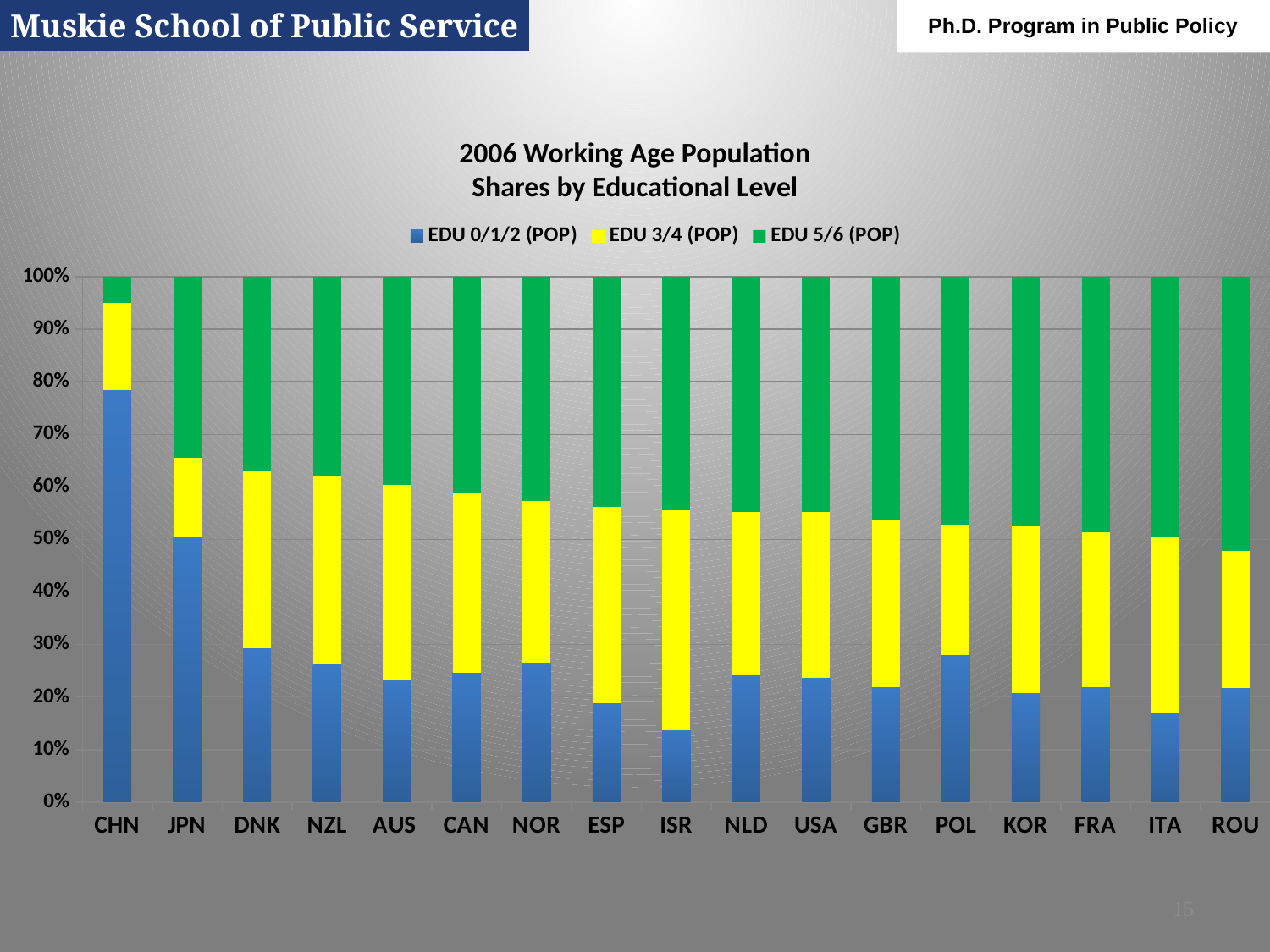
Which country has the largest share for EDU 5/6 (POP)? ROU Which country has the smallest share for EDU 5/6 (POP)? CHN Is the EDU 0/1/2 (POP) share for CHN greater or less than 70%? greater How many series does the legend list? 3 How many countries are shown on the x axis? 17 Is the EDU 0/1/2 (POP) share for ISR greater or less than 20%? less What is the title of the chart? 2006 Working Age Population Shares by Educational Level Which country has the highest share for EDU 0/1/2 (POP)? CHN Which country has the lowest share for EDU 0/1/2 (POP)? ISR Which series is shown in green? EDU 5/6 (POP) Which is larger, the EDU 0/1/2 (POP) share for CHN or for ISR? CHN What kind of chart is shown on the slide? Stacked bar chart